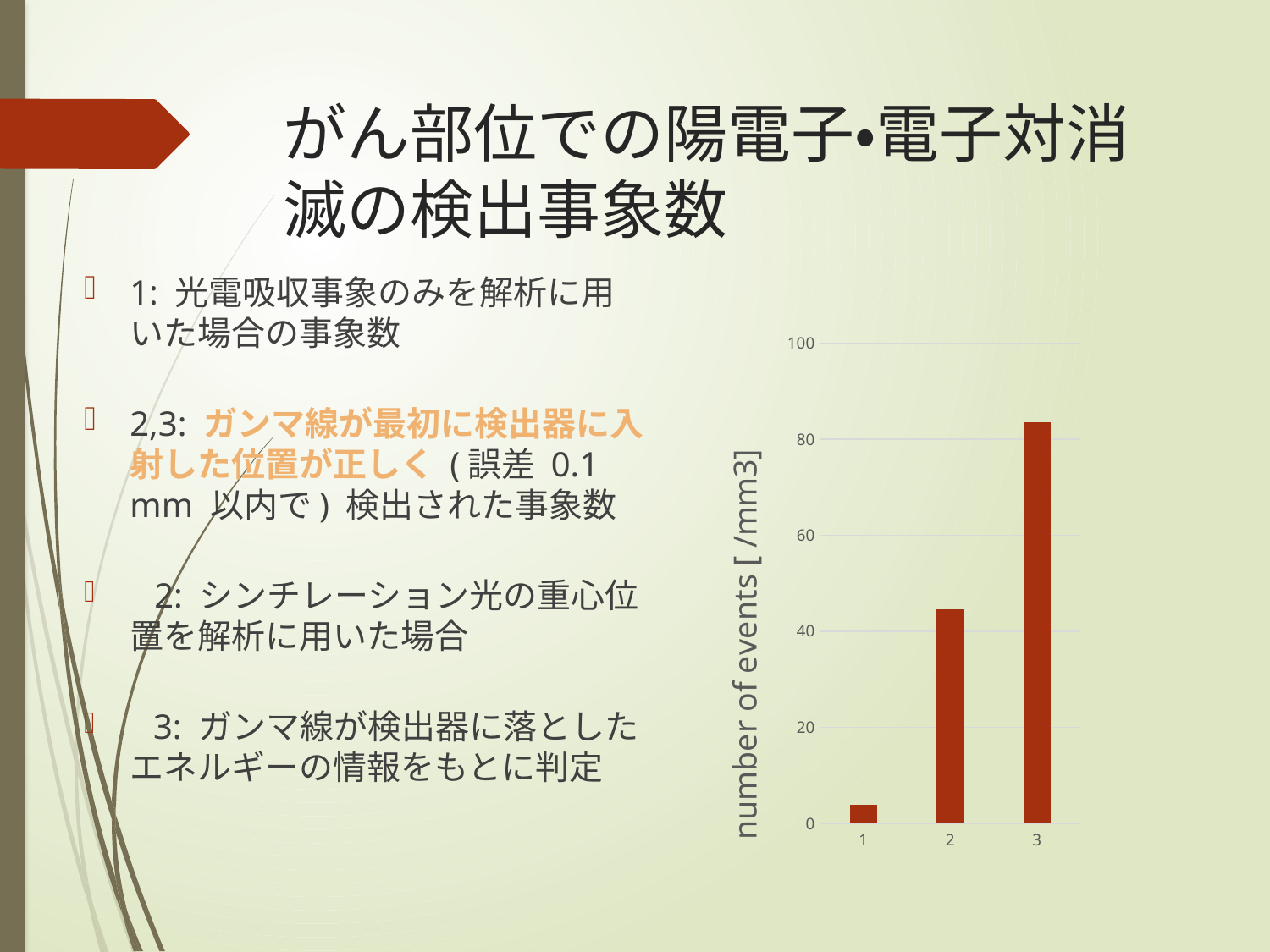
Is the value for category 3 greater or less than 60? greater Do the values rise or fall from category 1 to category 3? rise Which category has the highest number of events? 3 What kind of chart is shown on the slide? bar chart Which category has the lowest number of events? 1 Which has a larger value, category 2 or category 3? 3 What is the label of the vertical axis of the chart? number of events [ /mm3] What is the highest tick value shown on the vertical axis? 100 Is the value for category 2 greater or less than 60? less Is the value for category 1 greater or less than 20? less How many categories are plotted on the x axis of the chart? 3